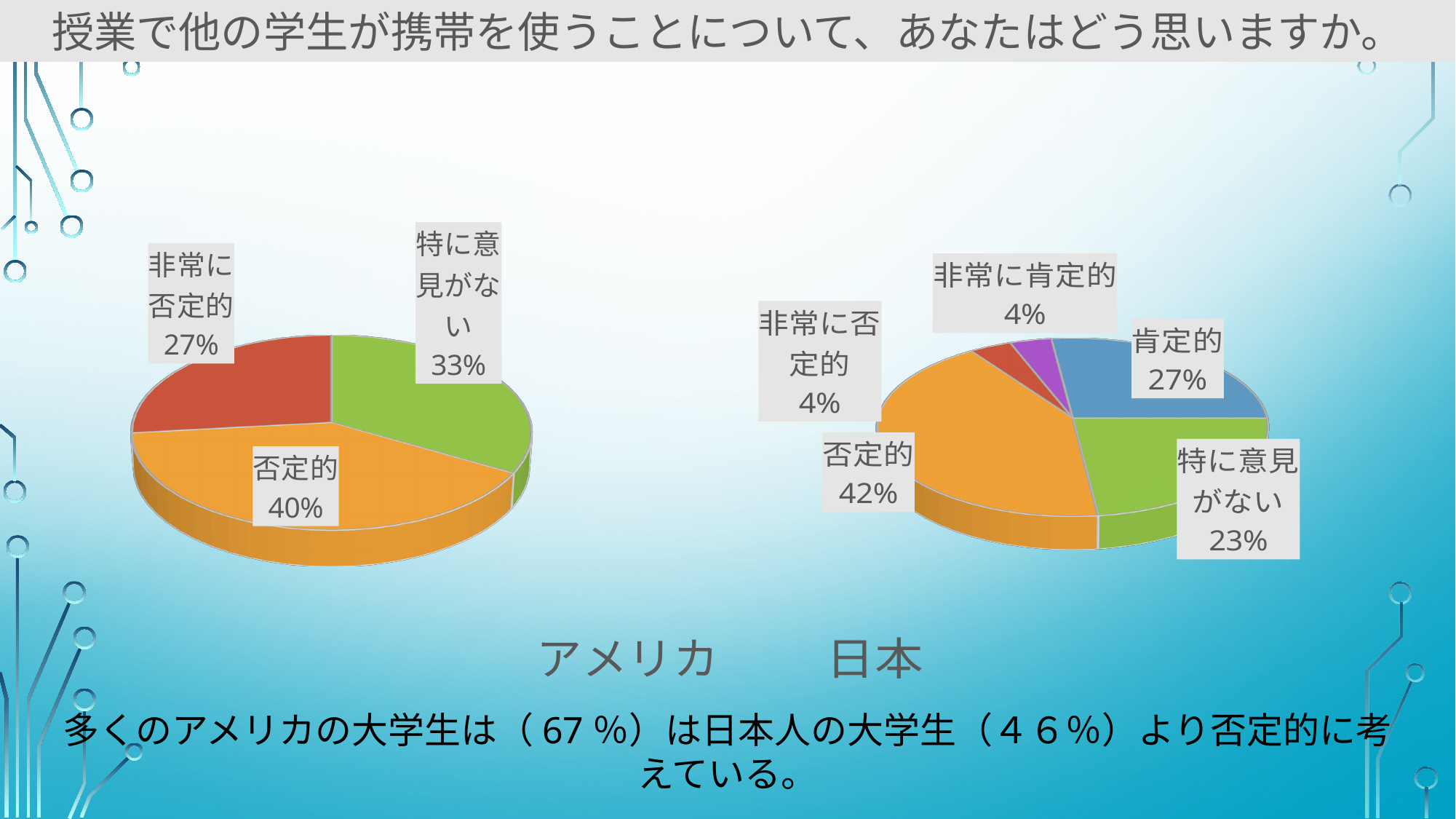
In the アメリカ pie chart, what is the difference between 否定的 and 非常に否定的? 13% In the 日本 pie chart, what percentage is 肯定的? 27% In the 日本 pie chart, what percentage is 非常に肯定的? 4% What type of chart is used for the アメリカ data? Pie chart In the 日本 pie chart, which category has the largest share? 否定的 Which is larger: 特に意見がない in the アメリカ chart or 特に意見がない in the 日本 chart? アメリカ In the 日本 pie chart, what is the difference between 否定的 and 特に意見がない? 19% In the アメリカ pie chart, what percentage is 否定的? 40% In the アメリカ pie chart, what percentage is 特に意見がない? 33% In the 日本 pie chart, which category has the smallest share, 肯定的 or 特に意見がない? 特に意見がない In the アメリカ pie chart, which category has the largest share? 否定的 How many slices does the 日本 pie chart have? 5